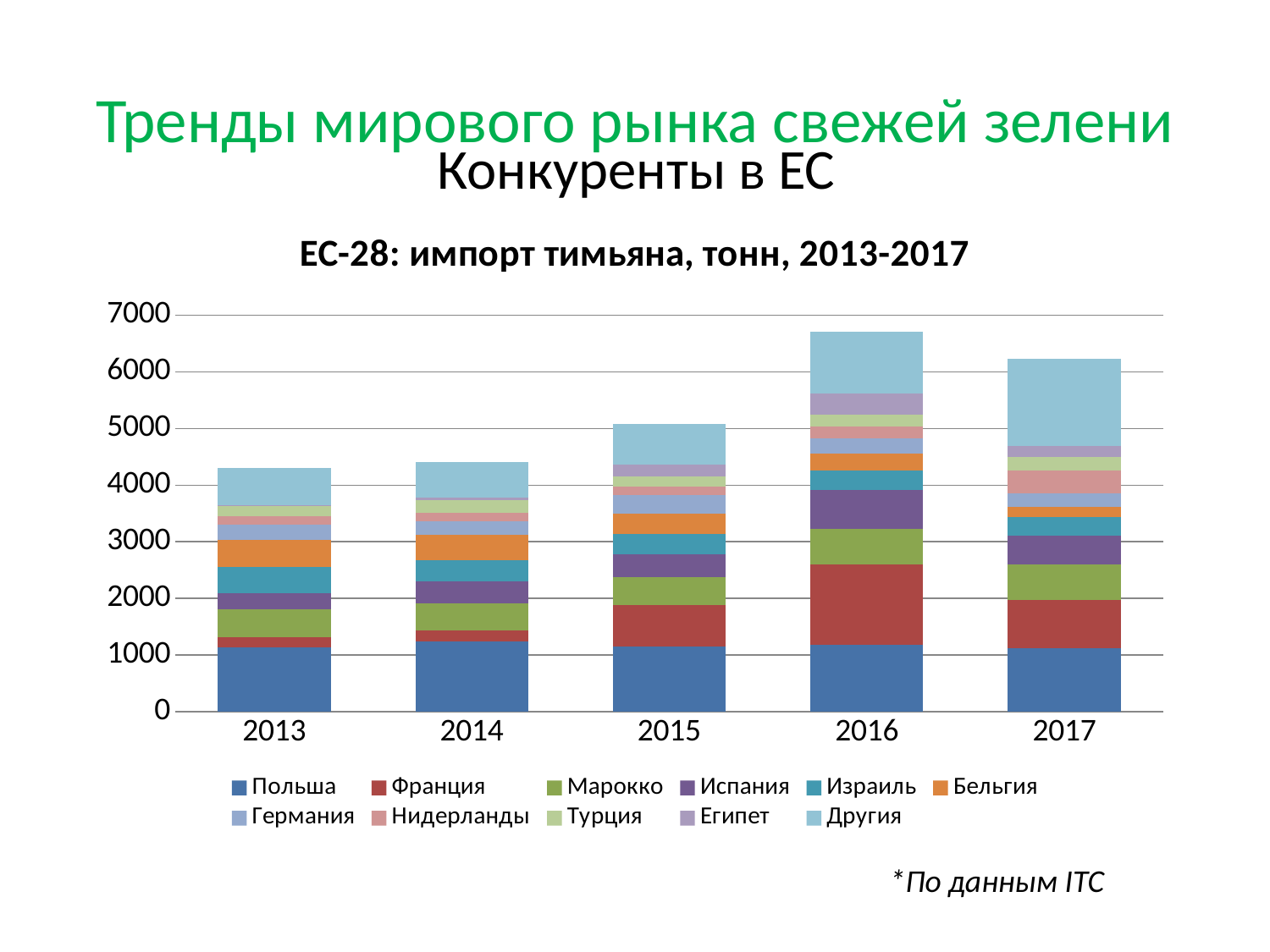
What is the title of the chart? ЕС-28: импорт тимьяна, тонн, 2013-2017 Which series is shown at the bottom of each stacked bar? Польша Which year has the highest total thyme imports? 2016 Is the total for 2015 greater or less than 6000? less How many series does the legend list? 11 Do the total imports rise or fall from 2013 to 2016? rise Is the total for 2013 greater or less than 5000? less Which year has the larger total, 2015 or 2016? 2016 Is the total for 2014 greater or less than 5000? less How many years (categories) are shown on the x axis? 5 What kind of chart is shown on the slide? stacked bar chart